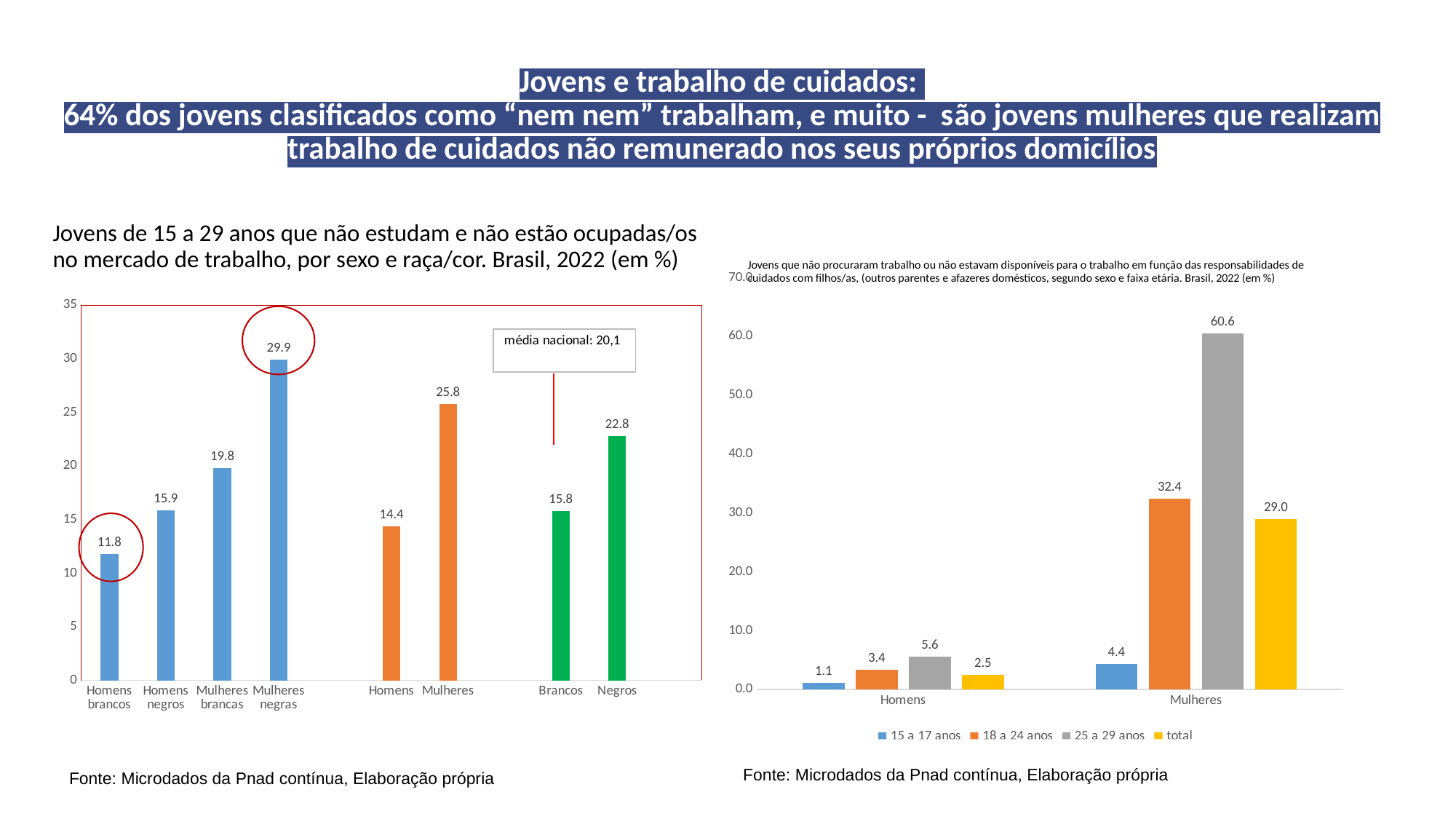
In the left chart, what is the value for Mulheres negras? 29.9 In the left chart, which category has the highest value? Mulheres negras In the left chart, which category has the lowest value? Homens brancos What kind of chart is the right chart? Bar chart In the left chart, what is the difference between the values for Mulheres and Homens? 11.4 In the left chart, which is larger, the value for Negros or the value for Brancos? Negros In the left chart, what is the value for Homens brancos? 11.8 In the right chart, what is the value for Mulheres in the 25 a 29 anos series? 60.6 In the left chart, what national average (média nacional) is shown in the text box? 20,1 In the right chart, what is the difference between the total values for Mulheres and Homens? 26.5 In the right chart, how many series does the legend list? 4 In the right chart, what is the value for Homens in the 15 a 17 anos series? 1.1